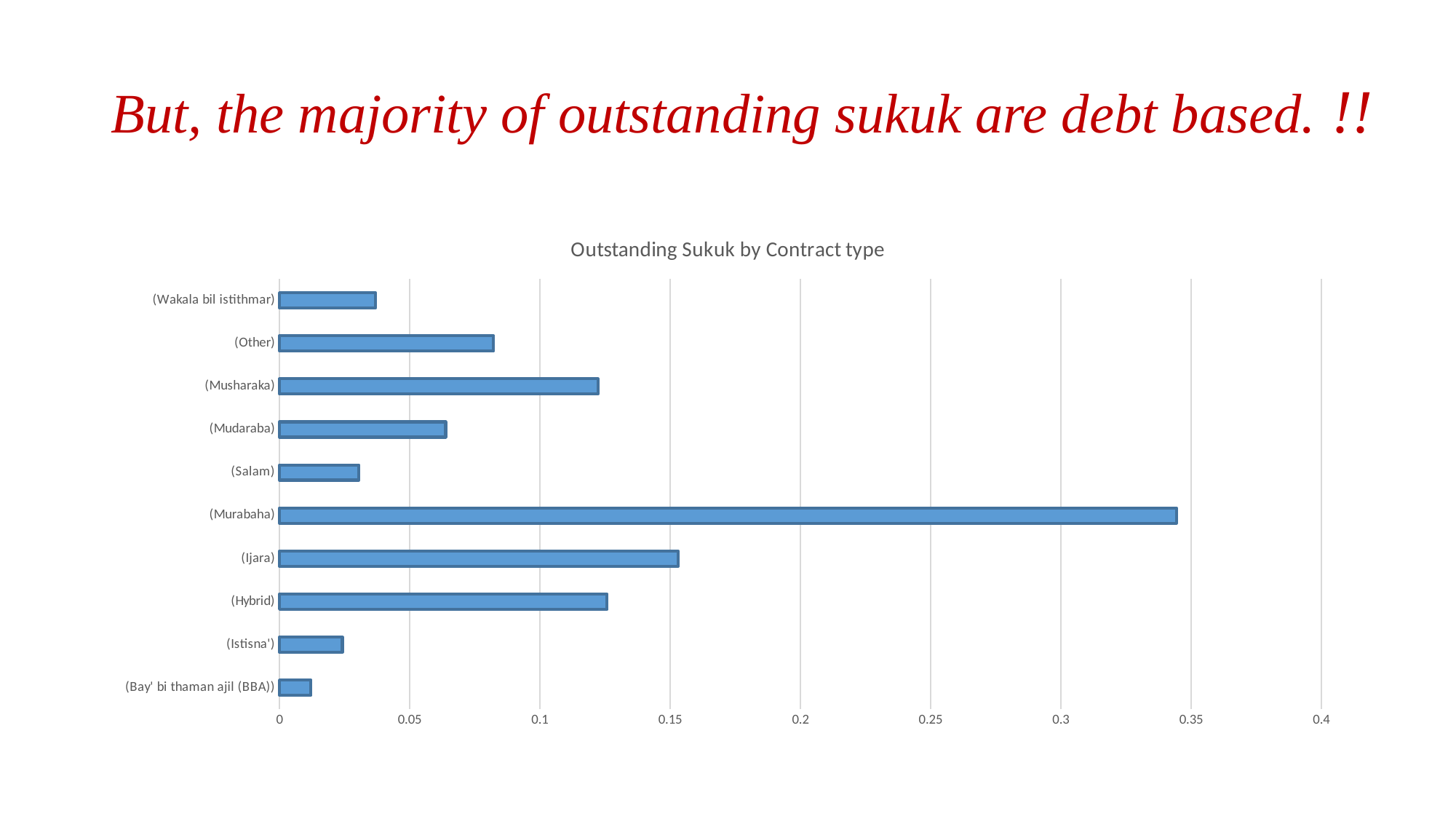
Which contract type has the highest value? (Murabaha) Is the value for (Salam) greater or less than 0.05? less How many contract types are shown in the chart? 10 Is the value for (Other) greater or less than 0.05? greater Which is larger, the value for (Other) or the value for (Mudaraba)? (Other) Is the value for (Murabaha) greater or less than 0.3? greater Which contract type has the lowest value? (Bay' bi thaman ajil (BBA)) What type of chart is shown on the slide? bar chart What is the title of the chart? Outstanding Sukuk by Contract type Which is larger, the value for (Ijara) or the value for (Hybrid)? (Ijara)